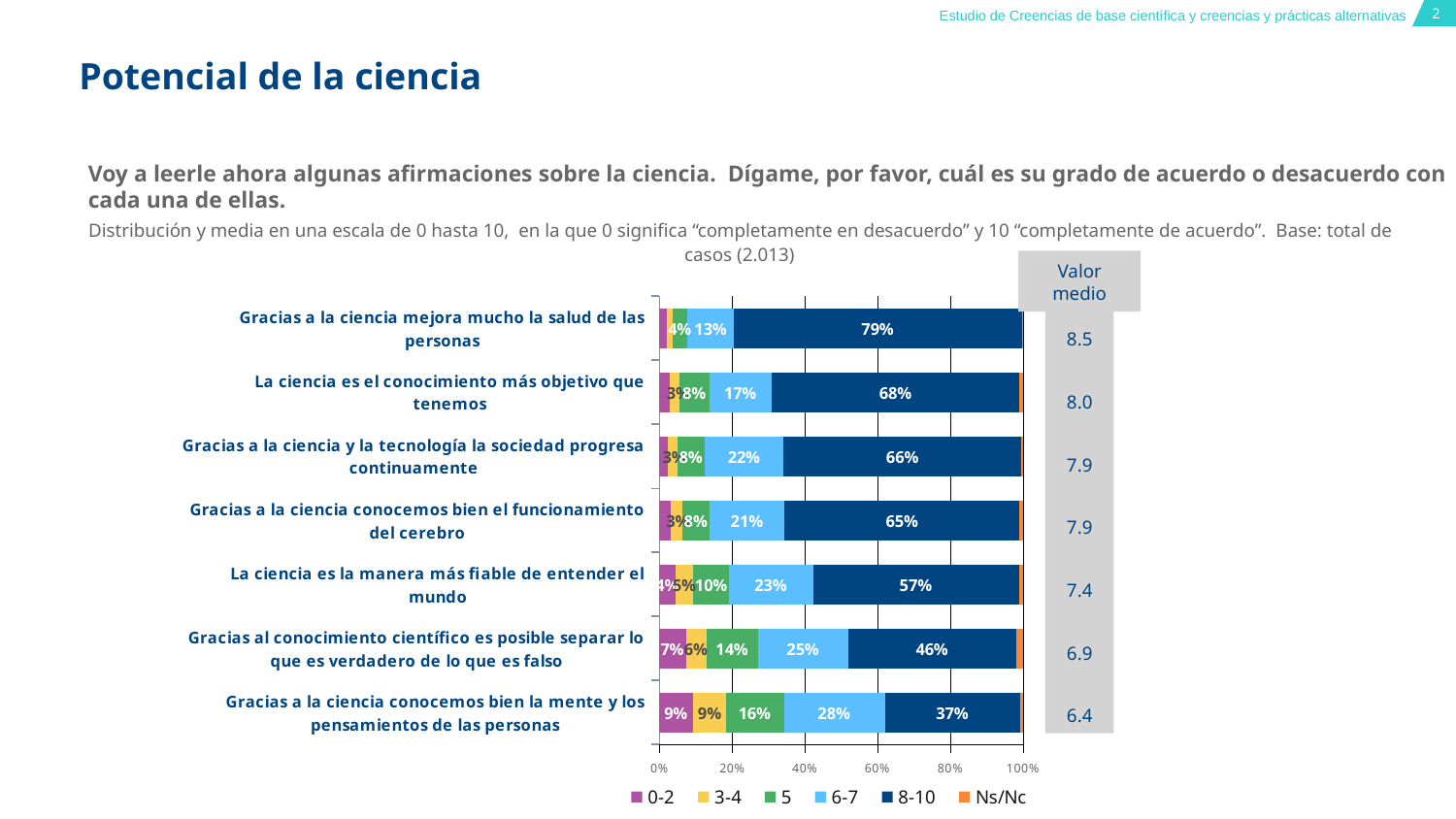
What is the 6-7 value for "Gracias a la ciencia conocemos bien la mente y los pensamientos de las personas"? 28% What type of chart is shown on the slide? stacked bar chart What is the "Valor medio" shown for "Gracias a la ciencia conocemos bien la mente y los pensamientos de las personas"? 6.4 What is the 8-10 value for "Gracias al conocimiento científico es posible separar lo que es verdadero de lo que es falso"? 46% Do the 8-10 values rise or fall going down the chart from the top statement to the bottom statement? fall Which is larger: the 6-7 value for "Gracias a la ciencia y la tecnología la sociedad progresa continuamente" or the 6-7 value for "Gracias a la ciencia conocemos bien el funcionamiento del cerebro"? Gracias a la ciencia y la tecnología la sociedad progresa continuamente What is the difference between the 8-10 values for "La ciencia es el conocimiento más objetivo que tenemos" and "La ciencia es la manera más fiable de entender el mundo"? 11% How many statements (categories) are plotted in the chart? 7 What is the 8-10 value for "Gracias a la ciencia mejora mucho la salud de las personas"? 79% Which statement has the lowest 8-10 value? Gracias a la ciencia conocemos bien la mente y los pensamientos de las personas Which statement has the highest 8-10 value? Gracias a la ciencia mejora mucho la salud de las personas How many series does the legend list? 6